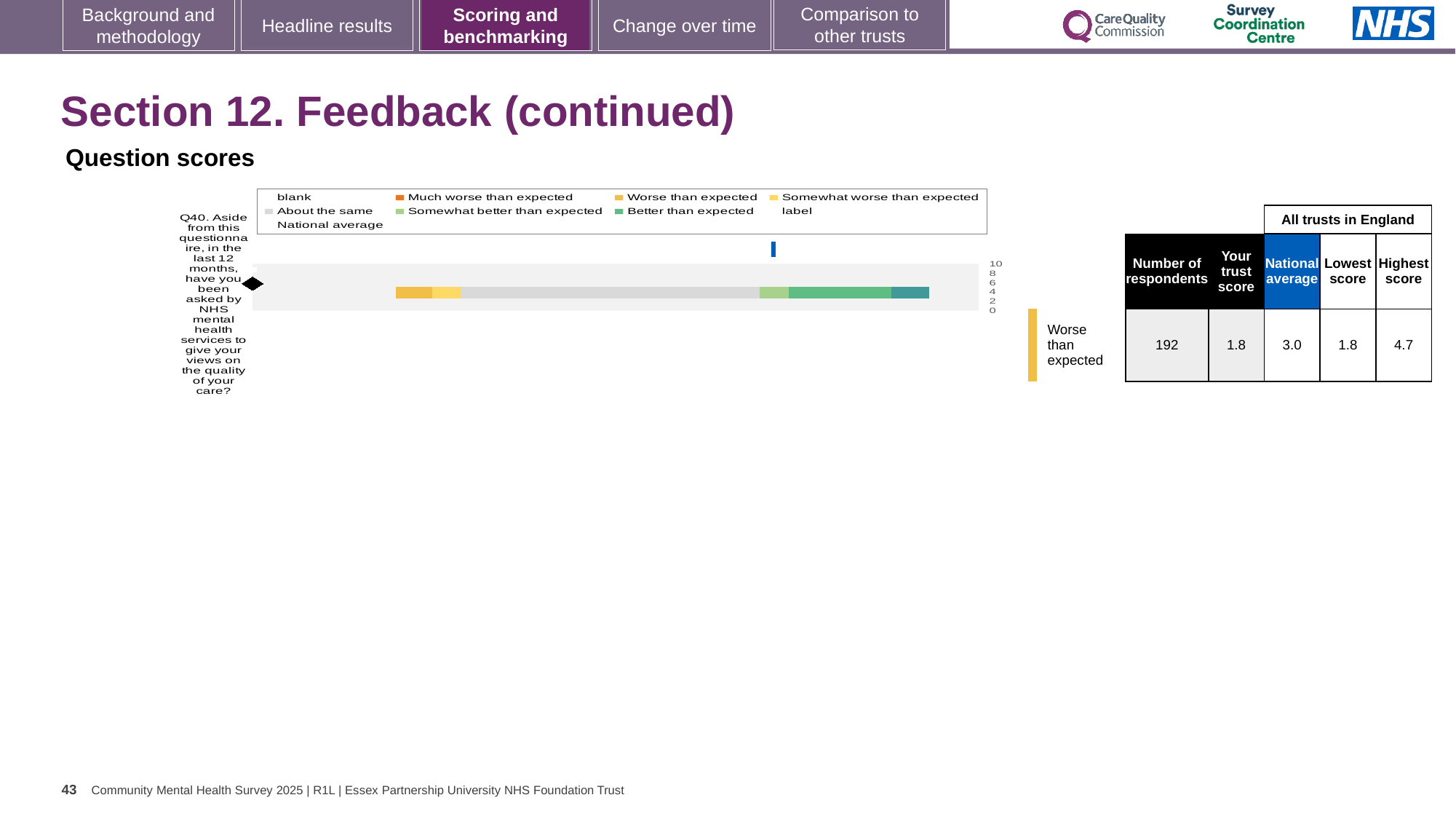
Is the trust score for Q40 larger or smaller than the national average? smaller What benchmark category is shown next to the question scores chart for Q40? Worse than expected Which question is plotted in the question scores chart? Q40. Aside from this questionnaire, in the last 12 months, have you been asked by NHS mental health services to give your views on the quality of your care? What is the national average for Q40 shown alongside the chart? 3.0 What is the highest score among all trusts in England for Q40? 4.7 What is the difference between the highest score and the lowest score for Q40 across all trusts in England? 2.9 How many questions (categories) are plotted in the question scores chart? 1 What is the lowest score among all trusts in England for Q40? 1.8 What is the trust score for Q40 shown alongside the chart? 1.8 What kind of chart is used to show the Q40 question score? bar chart How many respondents answered Q40? 192 How many entries does the legend of the question scores chart list? 9